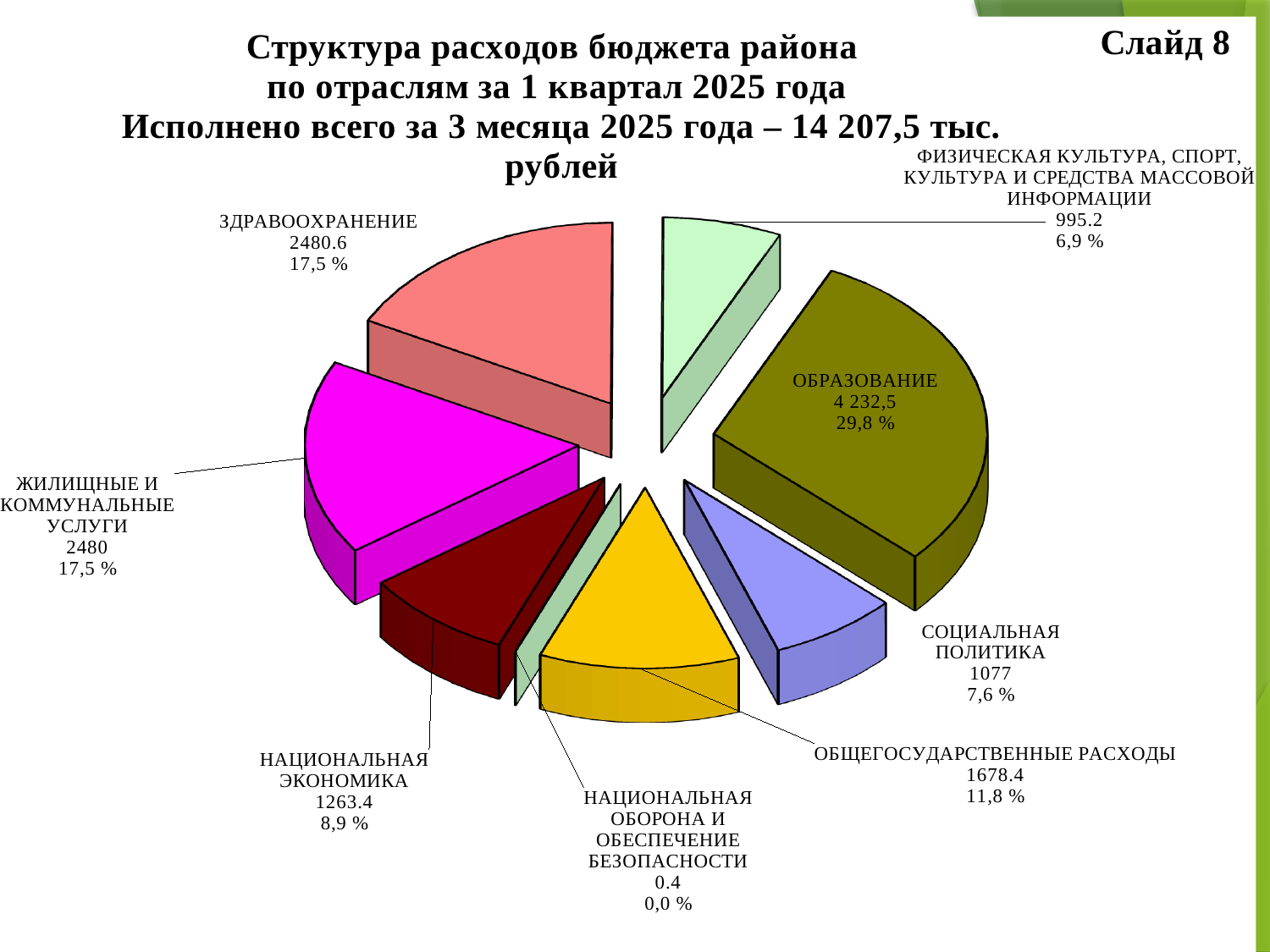
What kind of chart is shown on the slide? Pie chart What is the value shown for СОЦИАЛЬНАЯ ПОЛИТИКА? 1077 Which category has the smallest share of the pie? НАЦИОНАЛЬНАЯ ОБОРОНА И ОБЕСПЕЧЕНИЕ БЕЗОПАСНОСТИ What is the difference between the values for ОБЩЕГОСУДАРСТВЕННЫЕ РАСХОДЫ and НАЦИОНАЛЬНАЯ ЭКОНОМИКА? 415 What percentage share is shown for ОБЩЕГОСУДАРСТВЕННЫЕ РАСХОДЫ? 11,8 % What percentage share is shown for ЗДРАВООХРАНЕНИЕ? 17,5 % Which category has the largest share of the pie? ОБРАЗОВАНИЕ What is the value shown for ОБРАЗОВАНИЕ? 4 232,5 According to the slide title, what is the total executed amount for 3 months of 2025? 14 207,5 тыс. рублей How many categories (slices) does the pie chart have? 8 Which is larger: the value for ОБЩЕГОСУДАРСТВЕННЫЕ РАСХОДЫ or the value for НАЦИОНАЛЬНАЯ ЭКОНОМИКА? ОБЩЕГОСУДАРСТВЕННЫЕ РАСХОДЫ What is the value shown for ФИЗИЧЕСКАЯ КУЛЬТУРА, СПОРТ, КУЛЬТУРА И СРЕДСТВА МАССОВОЙ ИНФОРМАЦИИ? 995.2